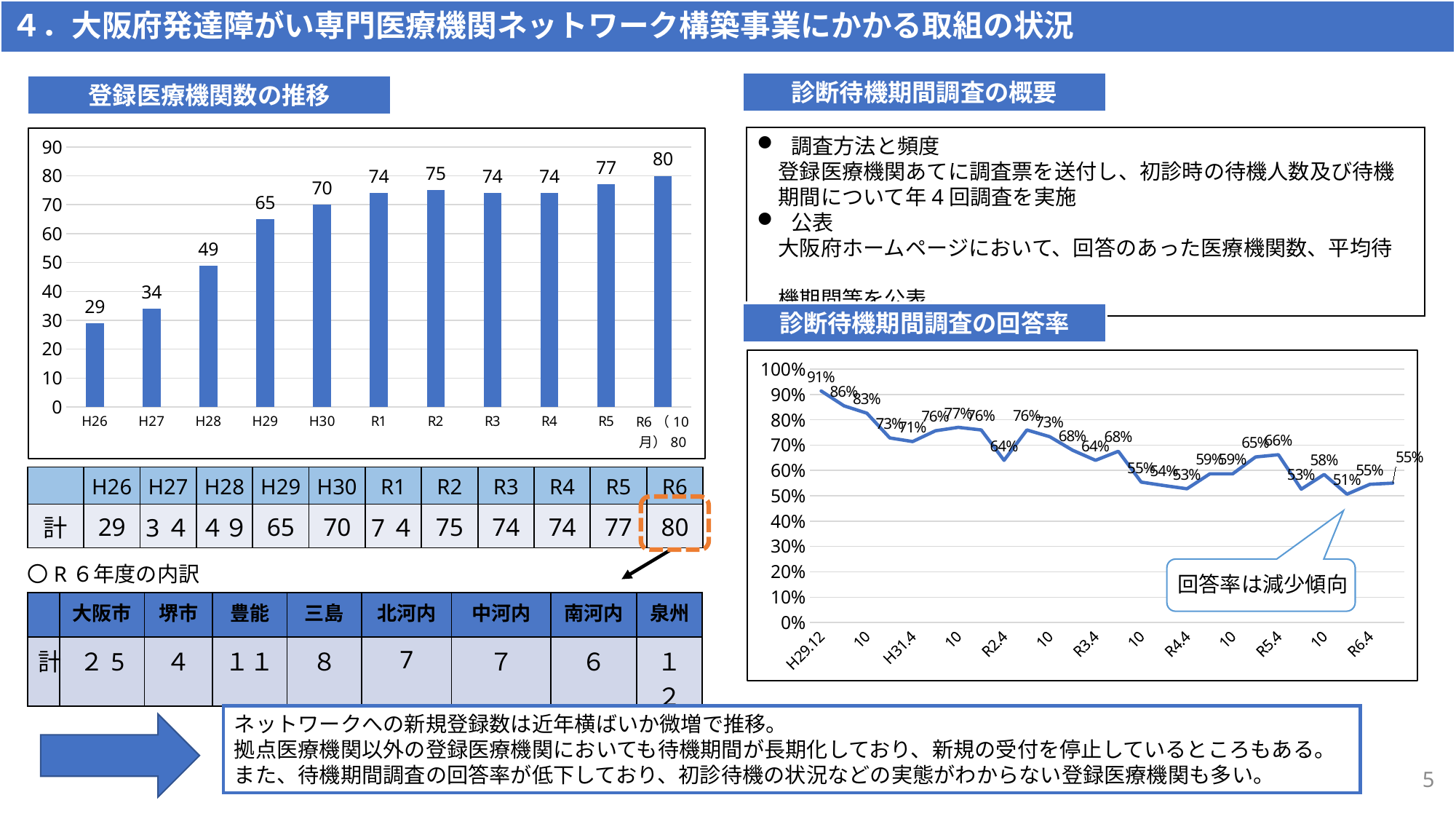
In the bar chart 登録医療機関数の推移, which category has the highest value? R6（10月） In the bar chart 登録医療機関数の推移, which is larger, the value for R2 or the value for R3? R2 What kind of chart is 登録医療機関数の推移? bar chart In the line chart 診断待機期間調査の回答率, what is the value at H29.12, the first point? 91% In the bar chart 登録医療機関数の推移, what is the value for H28? 49 In the bar chart 登録医療機関数の推移, what is the value for R5? 77 In the bar chart 登録医療機関数の推移, which category has the lowest value? H26 In the line chart 診断待機期間調査の回答率, what is the lowest value plotted? 51% How many bars are plotted in the bar chart 登録医療機関数の推移? 11 What kind of chart is 診断待機期間調査の回答率? line chart In the bar chart 登録医療機関数の推移, do the values generally rise or fall from H26 to R6? rise In the bar chart 登録医療機関数の推移, what is the difference between the values for H29 and H28? 16